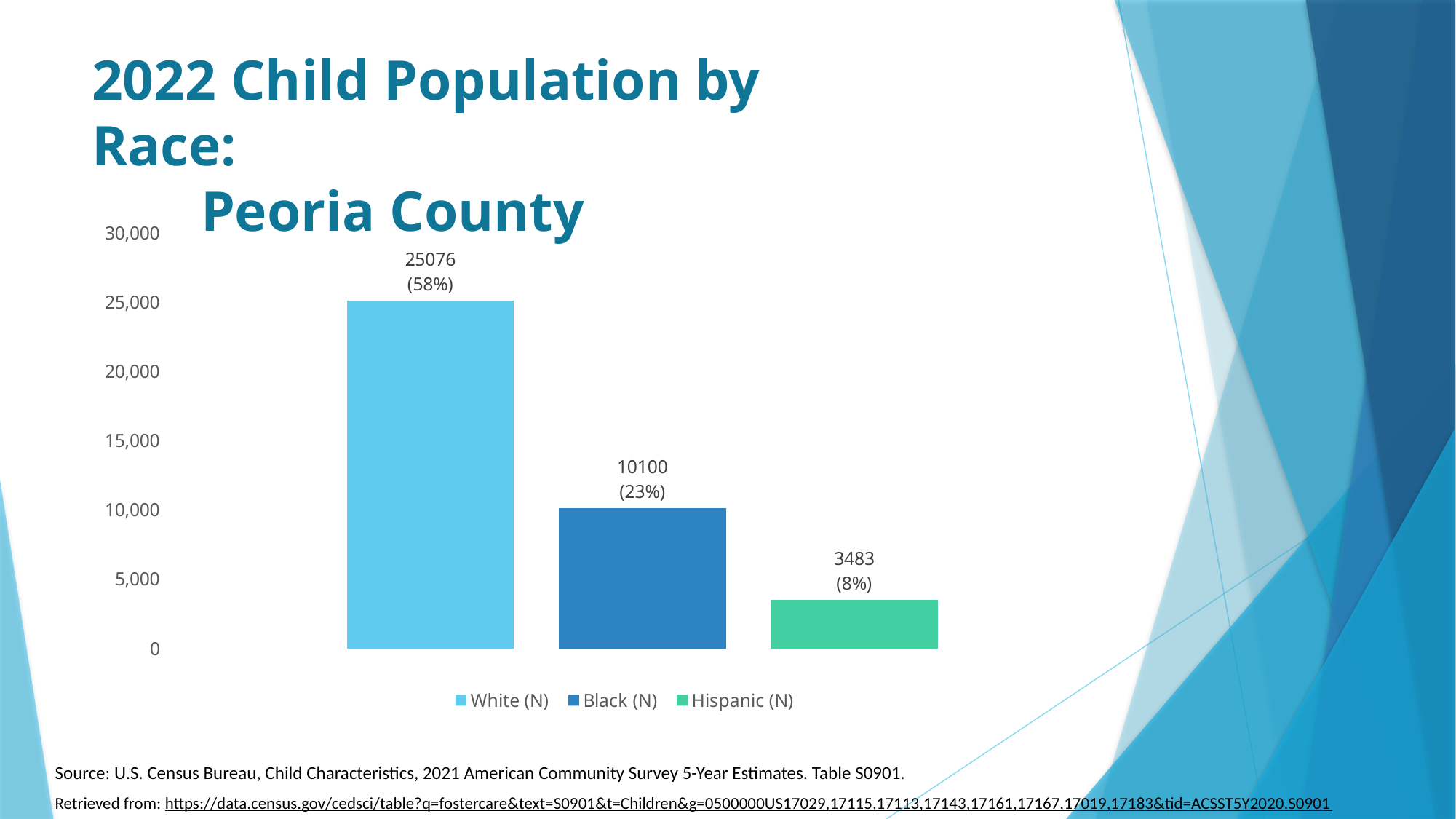
How many bars are plotted in the chart? 3 What is the child population value shown for White (N)? 25076 What is the difference between the White (N) and Black (N) values? 14976 Is the value for Hispanic (N) greater or less than 5,000? less What kind of chart is shown on the slide? bar chart What is the title of the chart? 2022 Child Population by Race: Peoria County What is the child population value shown for Black (N)? 10100 Which is larger, the value for Black (N) or Hispanic (N)? Black (N) What is the child population value shown for Hispanic (N)? 3483 Which group has the lowest child population? Hispanic (N) Which group has the highest child population? White (N) What percentage is shown for the Black (N) bar? 23%